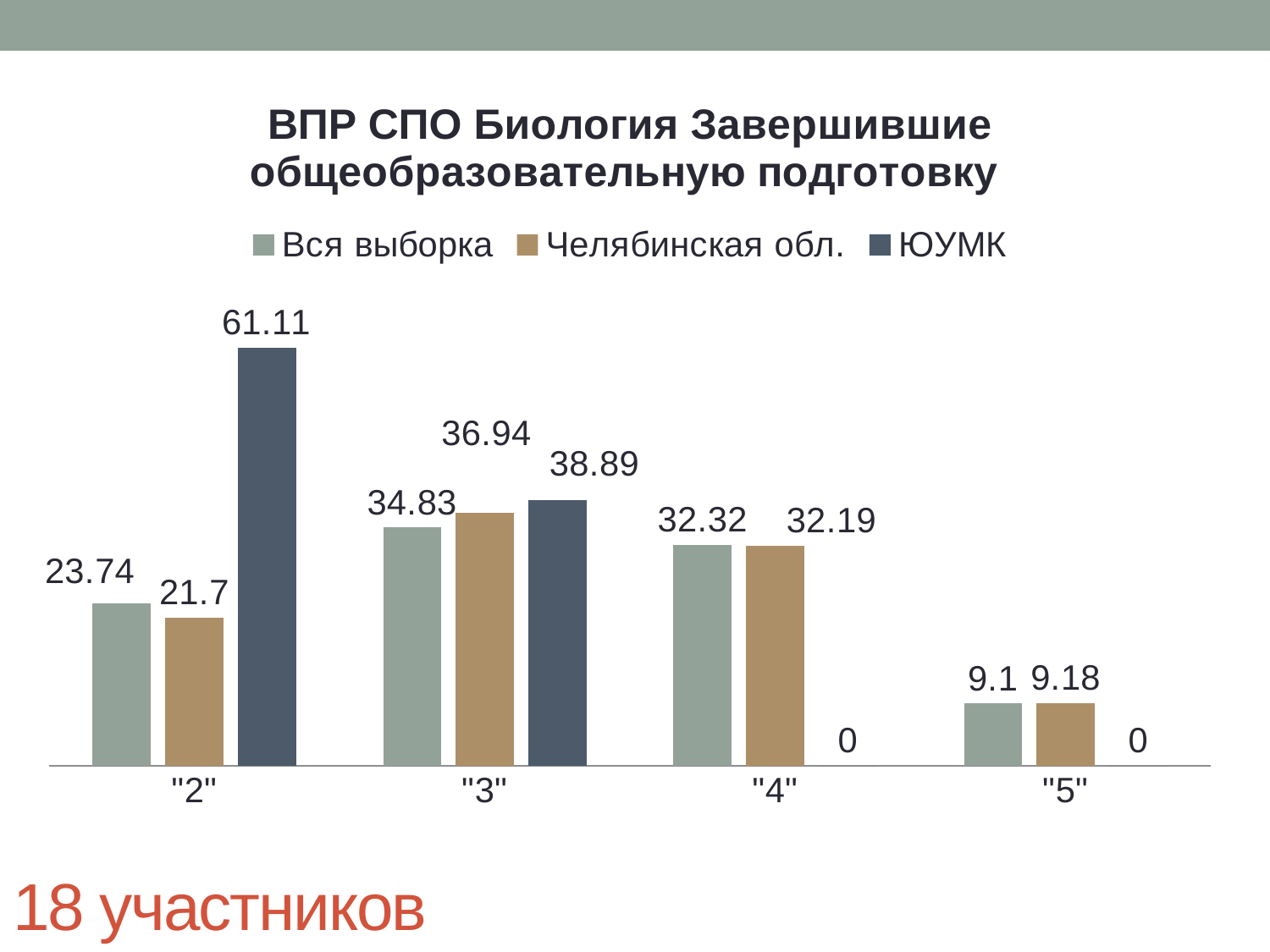
How many series does the legend list? 3 What is the difference between the ЮУМК value and the Вся выборка value in category "2"? 37.37 Which series is shown in dark blue-grey in the legend? ЮУМК What is the value for ЮУМК in category "2"? 61.11 What is the value for Вся выборка in category "3"? 34.83 How many categories are shown on the x axis? 4 Which category has the highest value for ЮУМК? "2" Which is larger in category "3": Челябинская обл. or ЮУМК? ЮУМК What is the value for ЮУМК in category "5"? 0 What is the value for Челябинская обл. in category "4"? 32.19 Which category has the lowest value for Вся выборка? "5" What kind of chart is shown on the slide? Bar chart